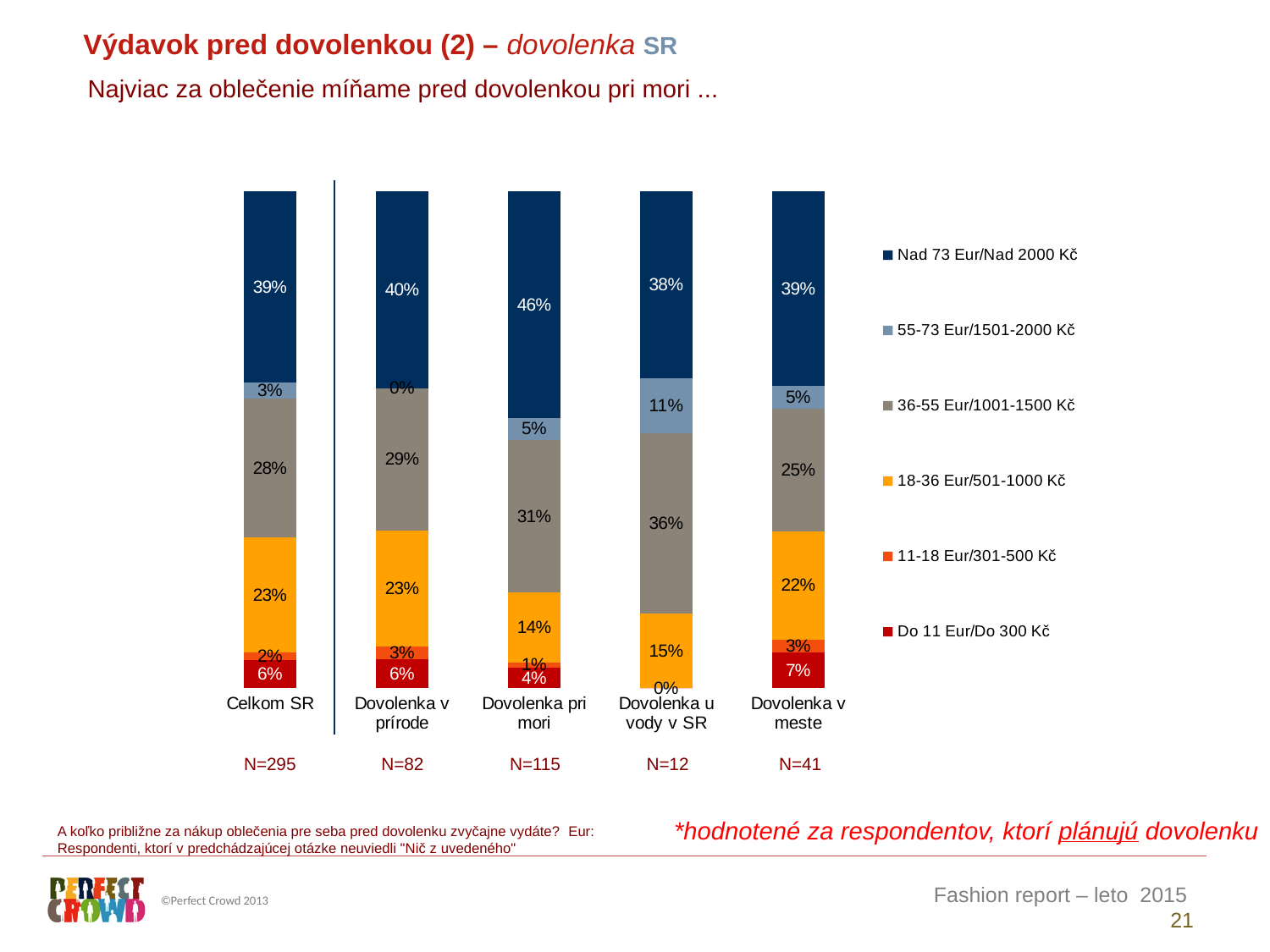
Which category has the highest share for 'Nad 73 Eur/Nad 2000 Kč'? Dovolenka pri mori Which category has the lowest share for '18-36 Eur/501-1000 Kč'? Dovolenka pri mori What is the value for '36-55 Eur/1001-1500 Kč' in the 'Dovolenka u vody v SR' category? 36% What is the difference between the '36-55 Eur/1001-1500 Kč' values for 'Dovolenka u vody v SR' and 'Dovolenka v meste'? 11 percentage points How many series does the legend list? 6 What kind of chart is shown on the slide? Stacked bar chart What is the sample size (N) shown for the 'Dovolenka pri mori' category? N=115 What is the value for '18-36 Eur/501-1000 Kč' in the 'Celkom SR' category? 23% What percentage of respondents in the 'Dovolenka pri mori' category spend 'Nad 73 Eur/Nad 2000 Kč'? 46% Which is larger: the '55-73 Eur/1501-2000 Kč' value for 'Dovolenka u vody v SR' or for 'Dovolenka v meste'? Dovolenka u vody v SR How many categories are shown on the x axis of the chart? 5 What is the value for 'Do 11 Eur/Do 300 Kč' in the 'Dovolenka v meste' category? 7%